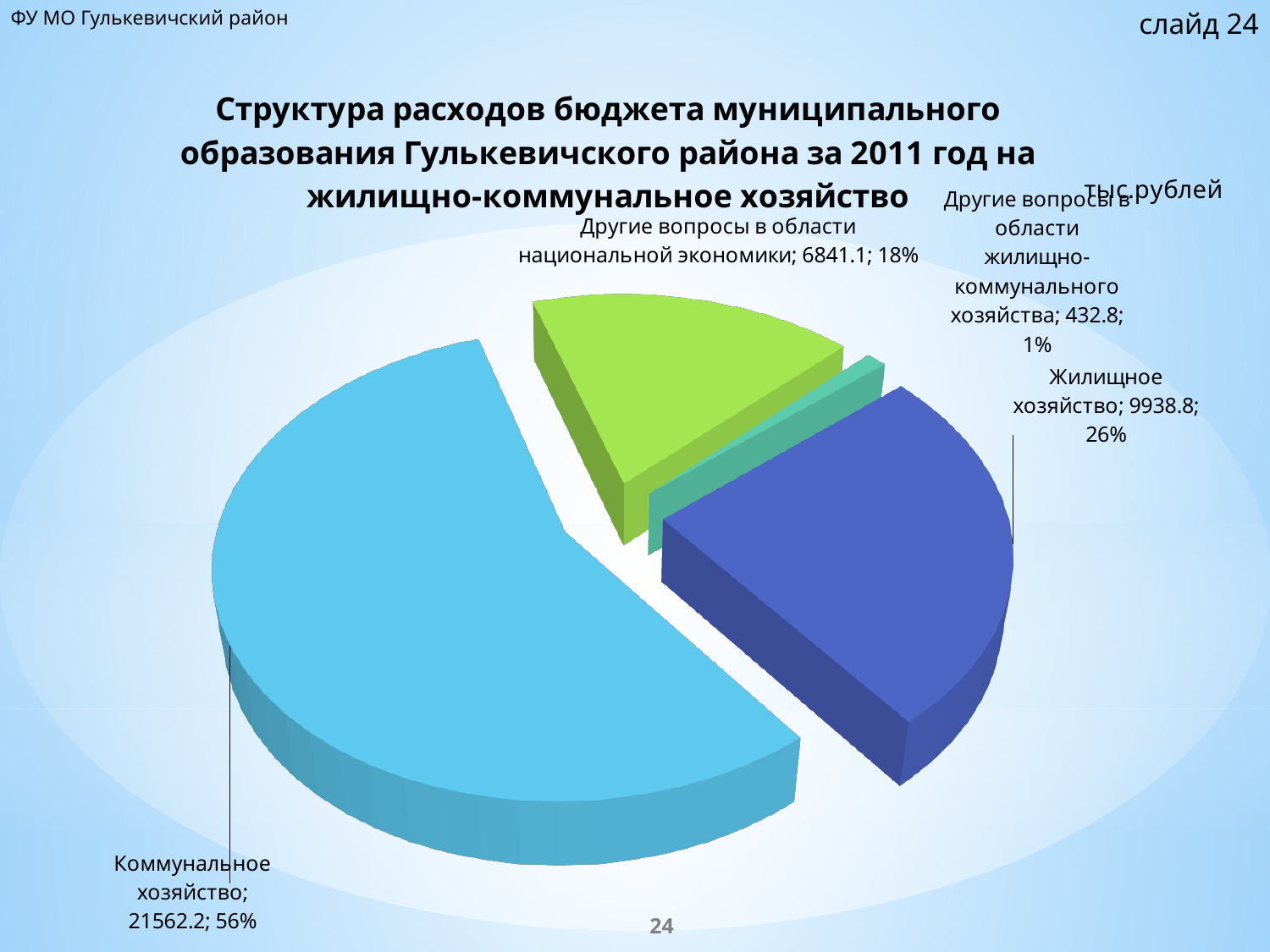
Which category has the largest share of the pie? Коммунальное хозяйство Which category has the smallest share of the pie? Другие вопросы в области жилищно-коммунального хозяйства What is the value for Другие вопросы в области жилищно-коммунального хозяйства? 432.8 How many slices does the pie chart have? 4 Which is larger: the value for Жилищное хозяйство or the value for Другие вопросы в области национальной экономики? Жилищное хозяйство What share of the pie does Жилищное хозяйство represent? 26% What is the value for Другие вопросы в области национальной экономики? 6841.1 What is the value for Жилищное хозяйство? 9938.8 What is the value for Коммунальное хозяйство? 21562.2 What share of the pie does Другие вопросы в области национальной экономики represent? 18% What kind of chart is shown on the slide? pie chart What is the difference between the values for Коммунальное хозяйство and Жилищное хозяйство? 11623.4